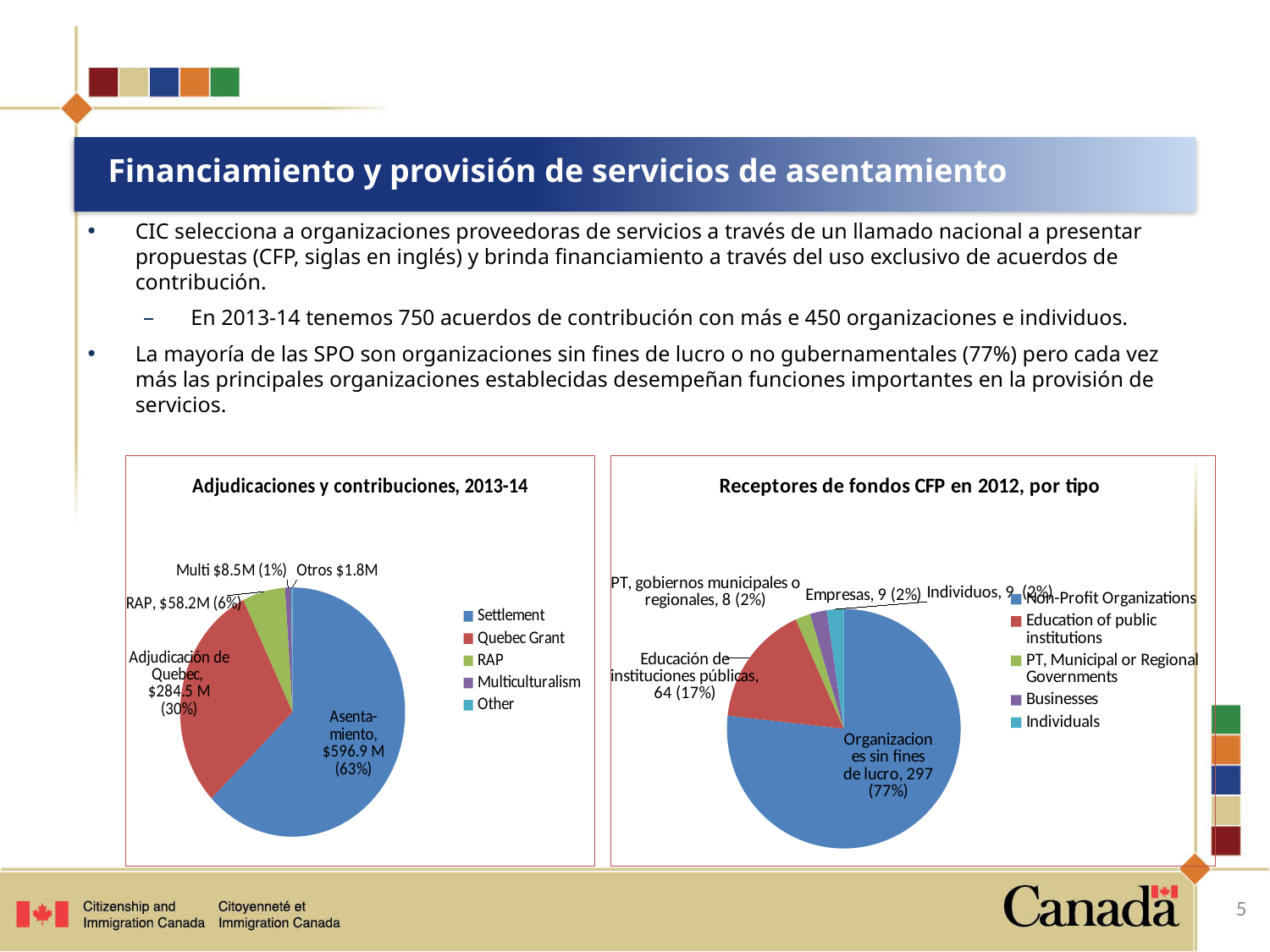
In the chart 'Receptores de fondos CFP en 2012, por tipo', what is the value for Educación de instituciones públicas? 64 (17%) In the chart 'Receptores de fondos CFP en 2012, por tipo', what is the difference between the number of Organizaciones sin fines de lucro and Educación de instituciones públicas? 233 In the chart 'Receptores de fondos CFP en 2012, por tipo', what is the value for Organizaciones sin fines de lucro? 297 (77%) In the chart 'Adjudicaciones y contribuciones, 2013-14', what is the value for Adjudicación de Quebec? $284.5 M (30%) In the chart 'Adjudicaciones y contribuciones, 2013-14', which category has the smallest slice? Otros In the chart 'Receptores de fondos CFP en 2012, por tipo', which is larger: Empresas or PT, gobiernos municipales o regionales? Empresas In the chart 'Adjudicaciones y contribuciones, 2013-14', how many entries does the legend list? 5 What kind of chart is 'Receptores de fondos CFP en 2012, por tipo'? Pie chart In the chart 'Adjudicaciones y contribuciones, 2013-14', which category has the largest slice? Asentamiento In the chart 'Adjudicaciones y contribuciones, 2013-14', what is the value for Asentamiento? $596.9 M (63%) In the chart 'Adjudicaciones y contribuciones, 2013-14', what is the value for RAP? $58.2M (6%) In the chart 'Adjudicaciones y contribuciones, 2013-14', what share of the pie does Adjudicación de Quebec represent? 30%